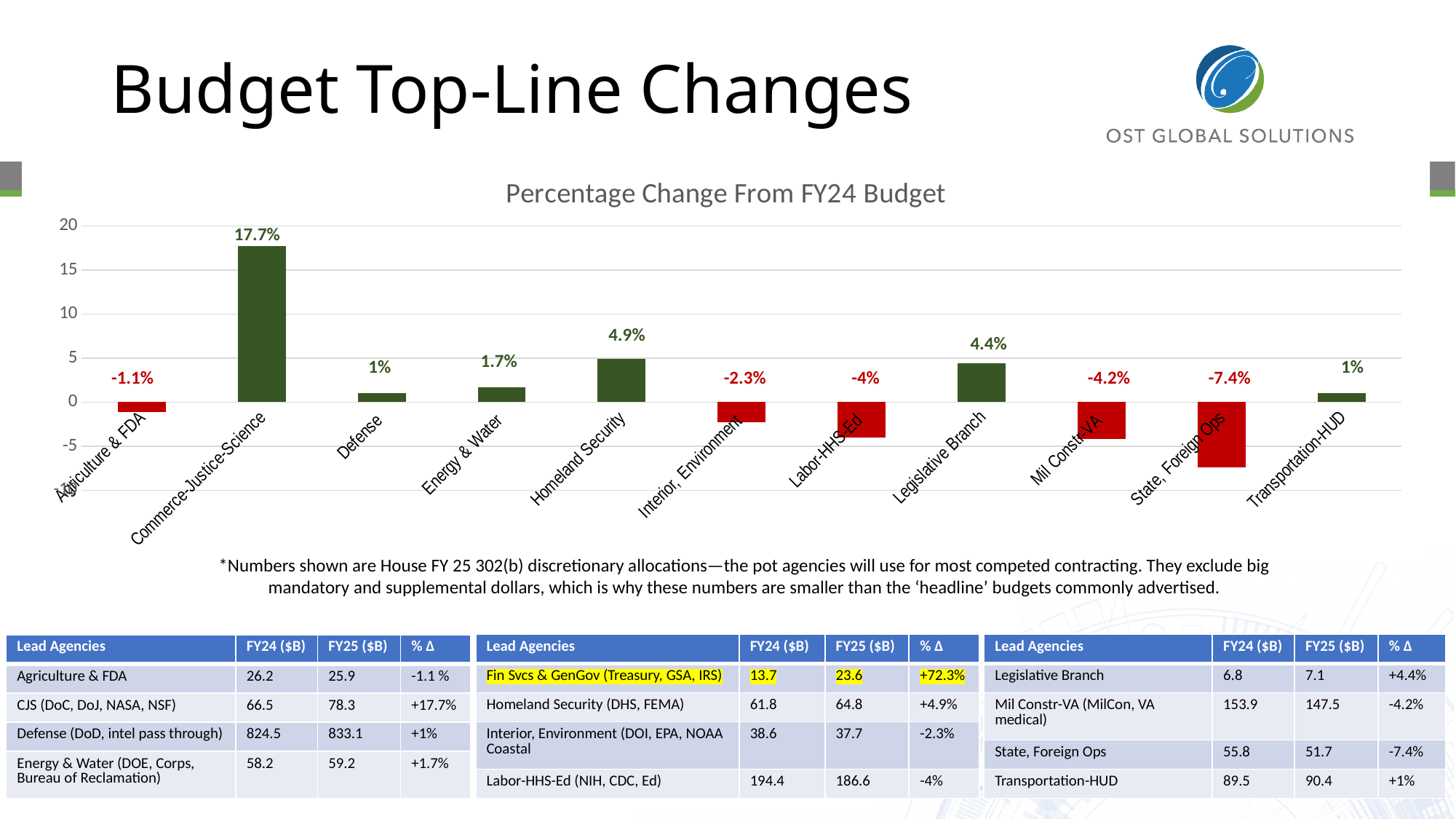
What is the title of the chart? Percentage Change From FY24 Budget What is the percentage change shown for State, Foreign Ops? -7.4% How many categories are plotted in the chart? 11 Which category has the lowest percentage change? State, Foreign Ops Which category has the highest percentage change? Commerce-Justice-Science What is the percentage change shown for Homeland Security? 4.9% What is the difference between the percentage change for Homeland Security and Legislative Branch? 0.5% What colour are the bars with negative percentage changes? red What type of chart is shown on the slide? bar chart Which is larger, the percentage change for Energy & Water or for Defense? Energy & Water What is the percentage change shown for Labor-HHS-Ed? -4% What is the percentage change shown for Commerce-Justice-Science? 17.7%